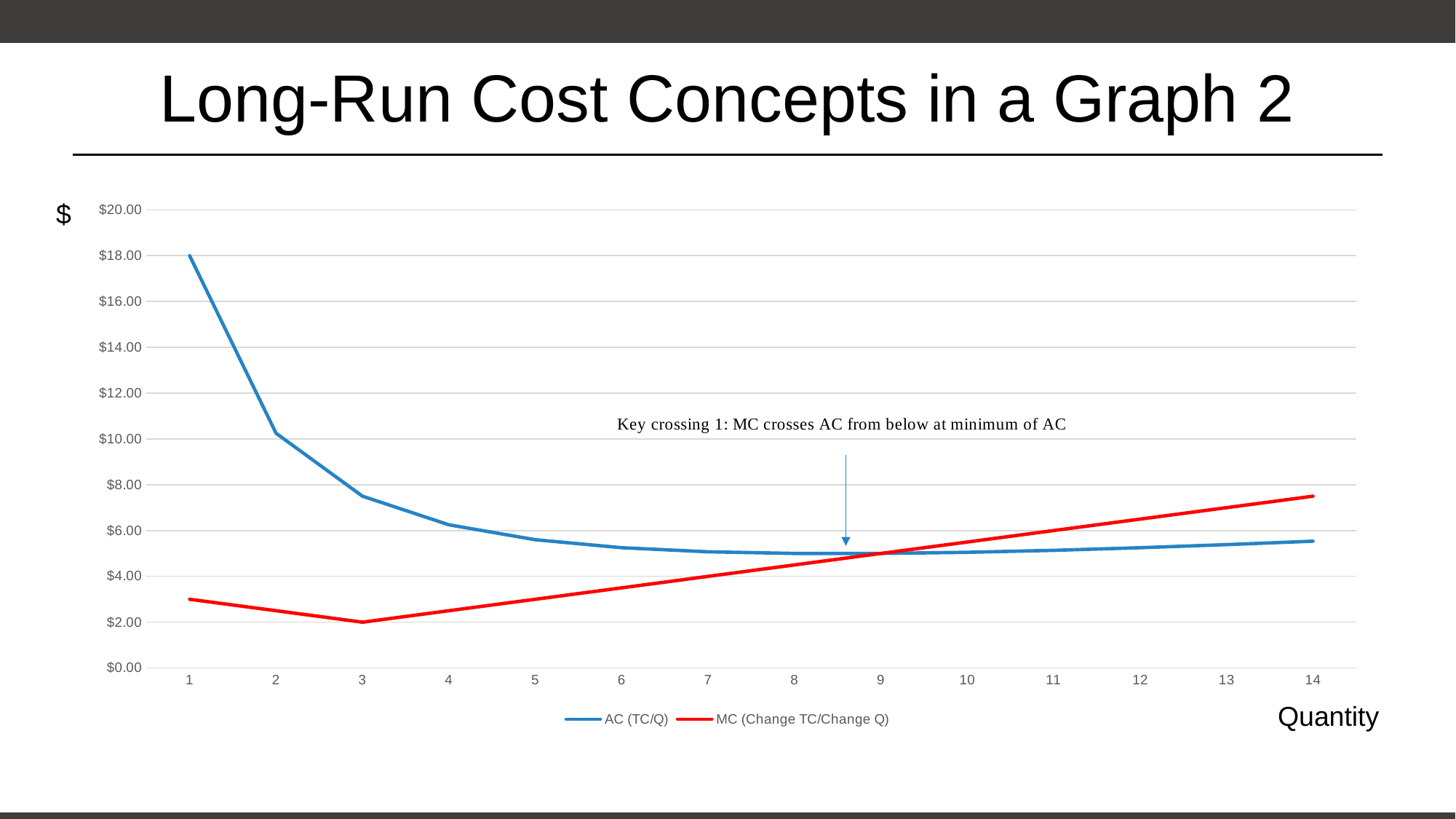
What kind of chart is shown on the slide? line chart How many series does the legend list? 2 How many quantity values are shown along the x axis? 14 At which quantity is MC (Change TC/Change Q) at its lowest? 3 At quantity 1, which series has the larger value, AC (TC/Q) or MC (Change TC/Change Q)? AC (TC/Q) What is the value of AC (TC/Q) at quantity 1? $18.00 What is the value of MC (Change TC/Change Q) at quantity 3? $2.00 Is the value of MC (Change TC/Change Q) at quantity 14 greater or less than $6.00? greater Does MC (Change TC/Change Q) rise or fall from quantity 3 to quantity 14? rise Is the value of AC (TC/Q) at quantity 2 greater or less than $8.00? greater At which quantity is AC (TC/Q) at its highest? 1 At quantity 14, which series has the larger value, AC (TC/Q) or MC (Change TC/Change Q)? MC (Change TC/Change Q)